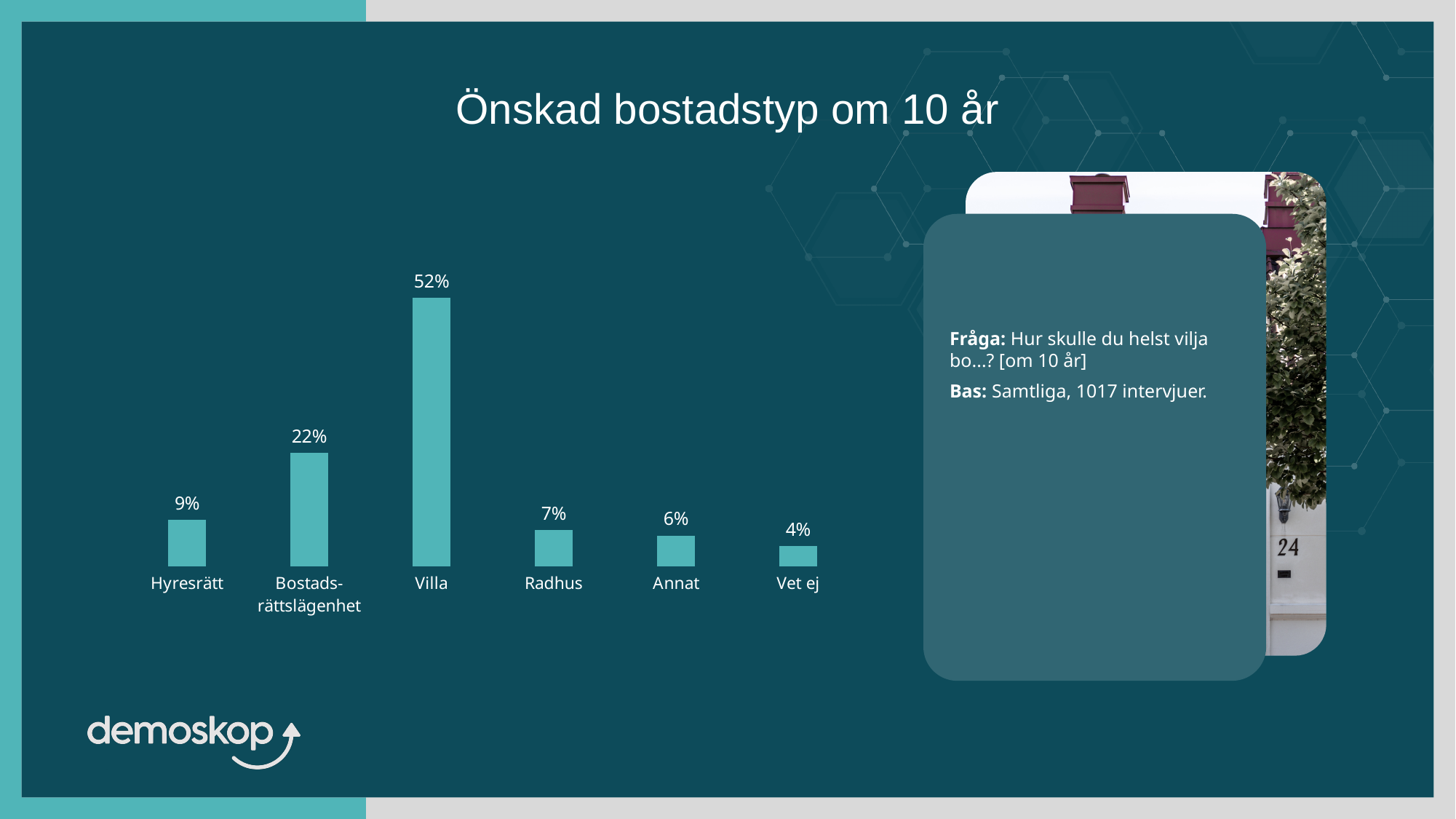
What is the value for Villa? 52% What is the value for Hyresrätt? 9% How many categories are shown in the chart? 6 What is the value for Vet ej? 4% What is the title of the chart? Önskad bostadstyp om 10 år What is the difference between the values for Villa and Bostadsrättslägenhet? 30% What is the value for Bostadsrättslägenhet? 22% Which is larger, the value for Radhus or the value for Annat? Radhus What is the difference between the values for Hyresrätt and Radhus? 2% What kind of chart is shown on the slide? Bar chart Which category has the lowest value? Vet ej Which category has the highest value? Villa